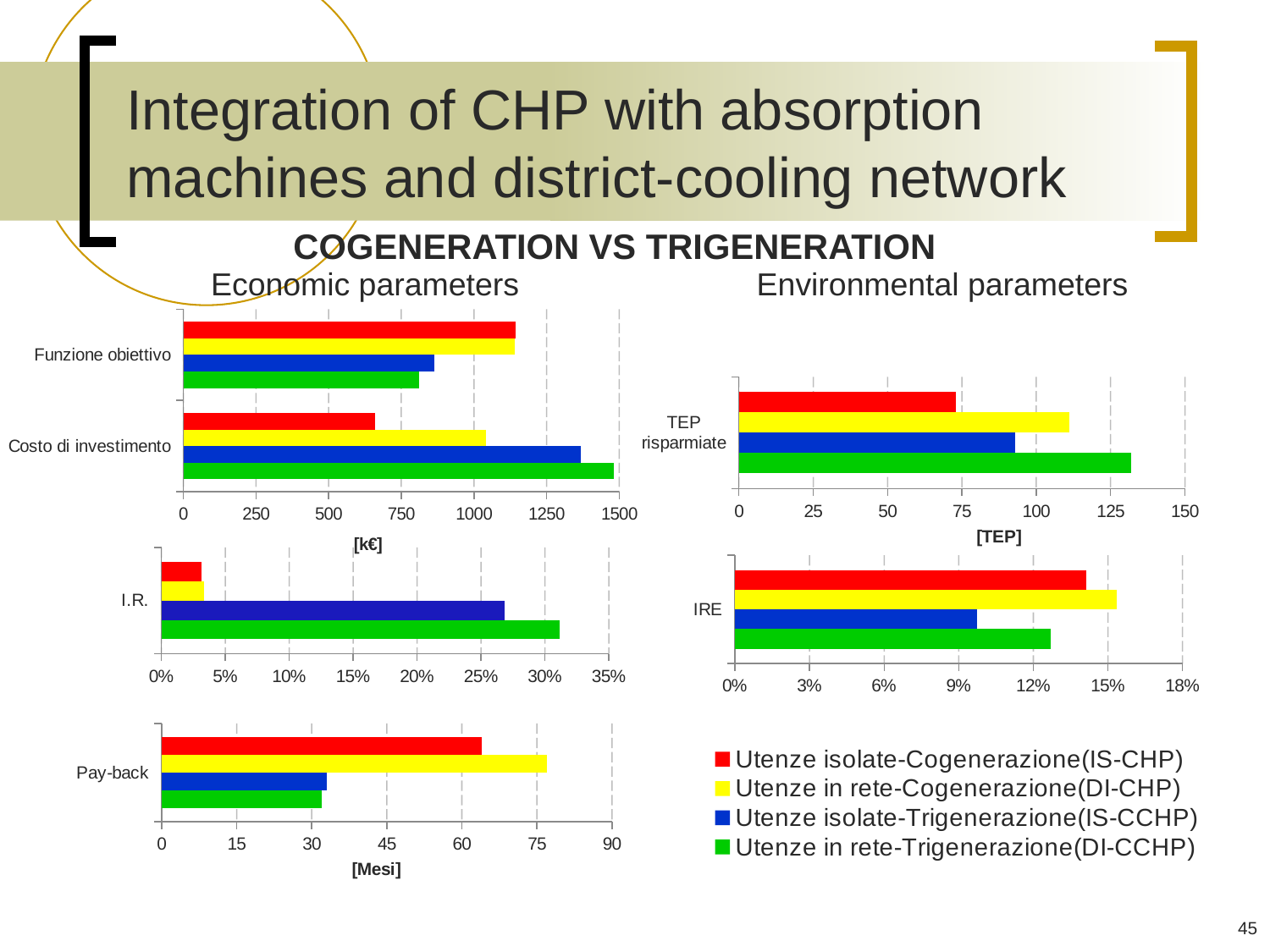
In the Pay-back chart, which is larger: Utenze isolate-Cogenerazione(IS-CHP) or Utenze in rete-Cogenerazione(DI-CHP)? Utenze in rete-Cogenerazione(DI-CHP) How many series does the legend list? 4 In the Economic parameters k€ chart, is the Costo di investimento for Utenze in rete-Trigenerazione(DI-CCHP) greater or less than 1250? greater What unit is shown on the x axis of the Pay-back chart? [Mesi] How many categories are shown in the Economic parameters k€ chart? 2 In the TEP risparmiate chart, which series has the highest value? Utenze in rete-Trigenerazione(DI-CCHP) What kind of chart is the Pay-back chart? bar chart In the I.R. chart, is the value for Utenze isolate-Cogenerazione(IS-CHP) greater or less than 5%? less In the IRE chart, which series has the lowest value? Utenze isolate-Trigenerazione(IS-CCHP) In the TEP risparmiate chart, is the value for Utenze in rete-Cogenerazione(DI-CHP) greater or less than 100? greater